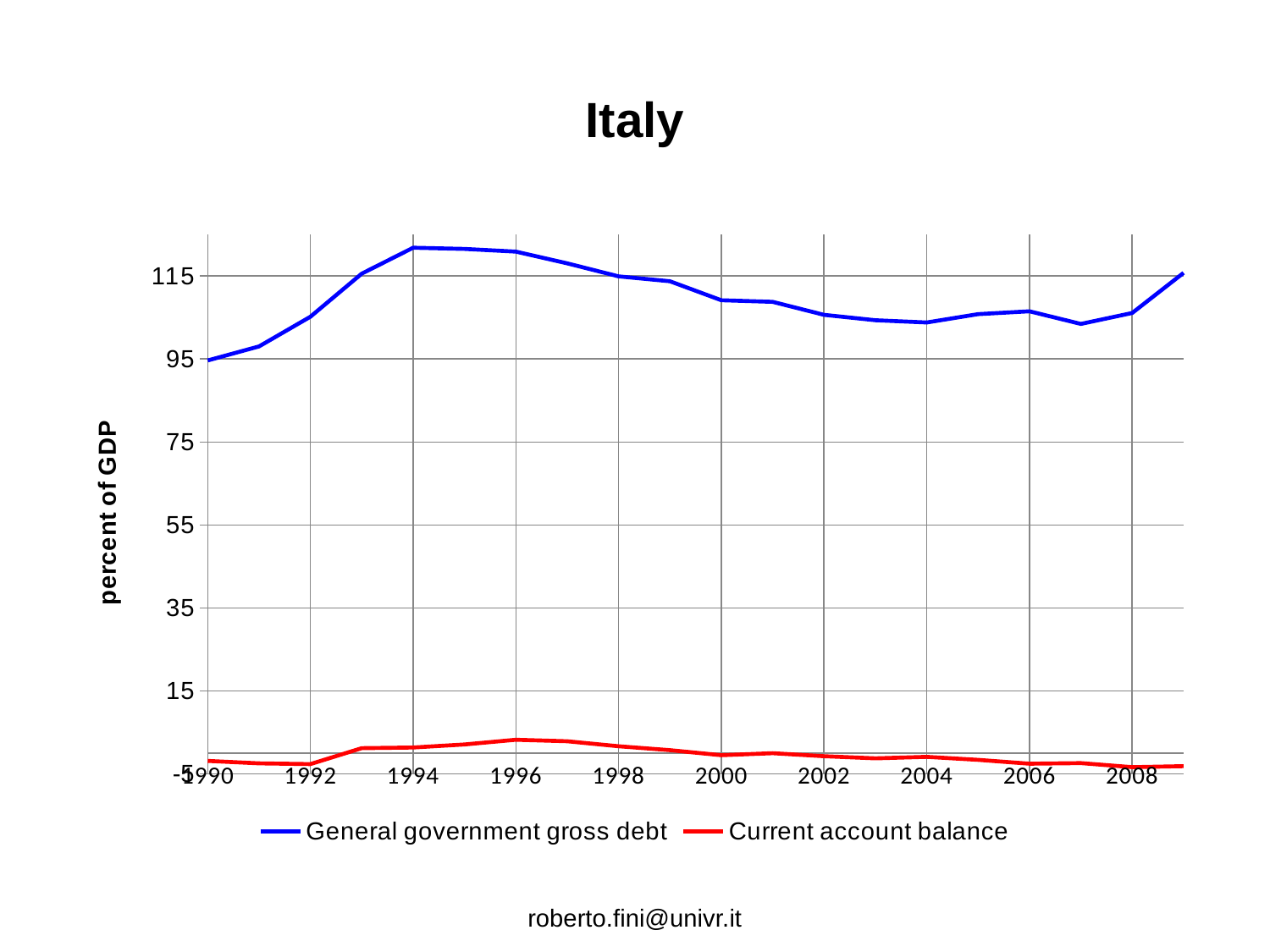
What is the title of the chart? Italy In which year is General government gross debt at its lowest? 1990 Is the value of General government gross debt in 2000 greater or less than 95? greater How many years are labeled on the x axis? 10 What is the label on the vertical axis? percent of GDP Is the value of General government gross debt in 1994 greater or less than 115? greater What kind of chart is shown on the slide? line chart Does General government gross debt rise or fall between 1990 and 1994? rise How many series does the legend list? 2 Which is larger, General government gross debt in 1994 or in 2004? 1994 Is the value of General government gross debt in 2004 greater or less than 115? less